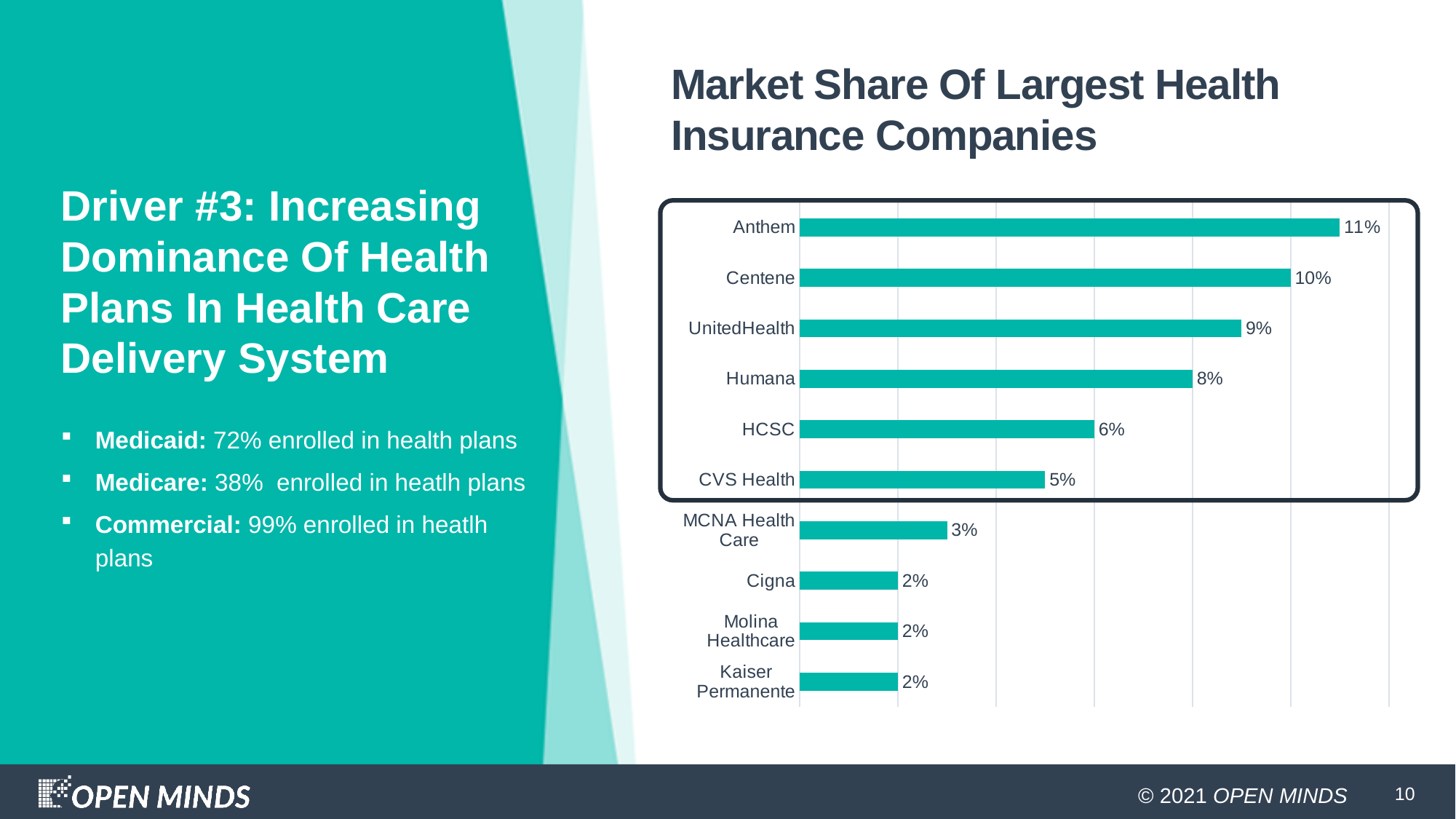
What is the market share shown for MCNA Health Care? 3% Do the market share values increase or decrease going down the chart from Anthem to Kaiser Permanente? Decrease What type of chart is used to show the market share of health insurance companies? Bar chart Which has a larger market share, Humana or Cigna? Humana What is the title of the chart? Market Share Of Largest Health Insurance Companies Which company has the highest market share in the chart? Anthem Which has a larger market share, HCSC or MCNA Health Care? HCSC What is the difference in market share between UnitedHealth and CVS Health? 4% What is the market share shown for Anthem? 11% What is the market share shown for Humana? 8% What is the difference in market share between Centene and HCSC? 4% How many companies are shown in the chart? 10